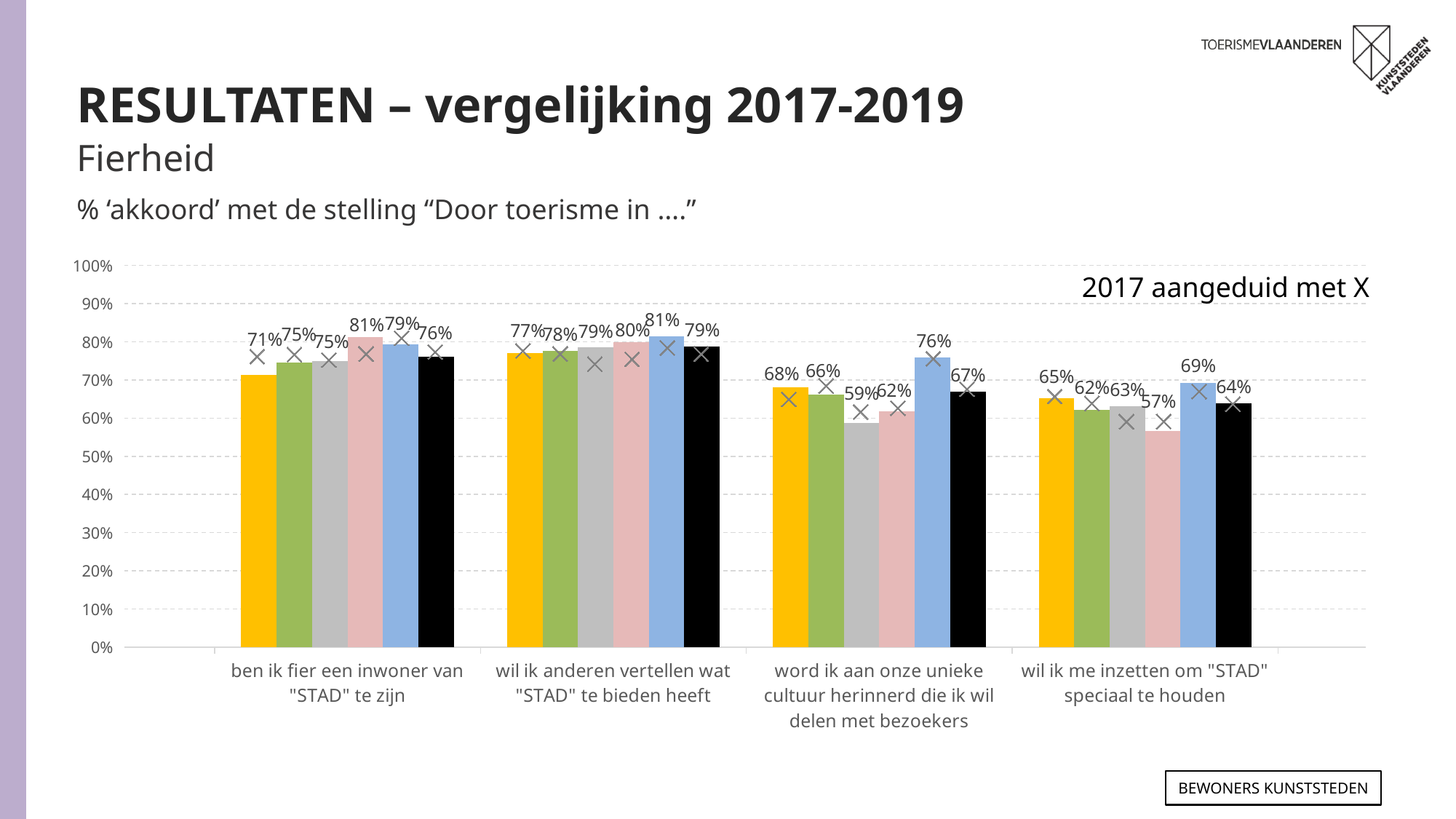
According to the note on the chart, what do the X markers indicate? 2017 values What kind of chart is shown on the slide? bar chart For "wil ik me inzetten om "STAD" speciaal te houden", what is the difference between the blue bar (69%) and the pink bar (57%)? 12 percentage points How many statement categories are shown along the x axis of the chart? 4 What is the lowest value shown for "word ik aan onze unieke cultuur herinnerd die ik wil delen met bezoekers"? 59% Is the value of the pink bar for "wil ik me inzetten om "STAD" speciaal te houden" greater or less than 60%? less What is the value of the blue bar for "word ik aan onze unieke cultuur herinnerd die ik wil delen met bezoekers"? 76% What is the value of the pink bar for "ben ik fier een inwoner van "STAD" te zijn"? 81% What is the value of the black bar for "ben ik fier een inwoner van "STAD" te zijn"? 76% Is the yellow bar higher for "ben ik fier een inwoner van "STAD" te zijn" or for "wil ik anderen vertellen wat "STAD" te bieden heeft"? wil ik anderen vertellen wat "STAD" te bieden heeft How many bars are plotted for each statement category? 6 What is the highest value shown for "wil ik me inzetten om "STAD" speciaal te houden"? 69%